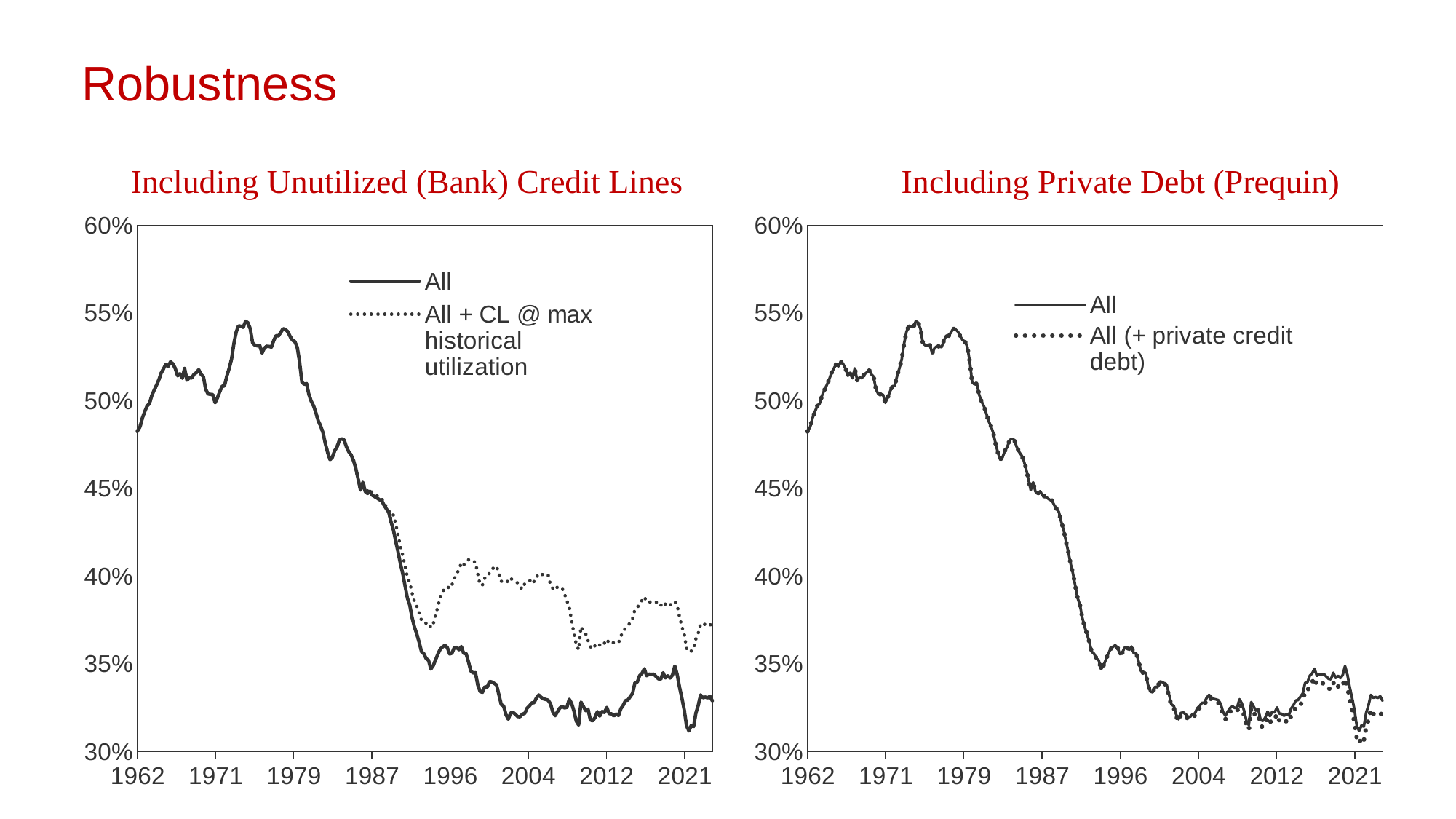
In the left chart titled "Including Unutilized (Bank) Credit Lines", which series has the higher value in 2004, "All" or "All + CL @ max historical utilization"? All + CL @ max historical utilization In the left chart titled "Including Unutilized (Bank) Credit Lines", is the value of the "All" series in 1962 greater or less than 50%? less In the right chart titled "Including Private Debt (Prequin)", does the "All" series overall rise or fall from 1979 to 2004? fall What kind of chart is the left chart titled "Including Unutilized (Bank) Credit Lines"? line chart In the left chart titled "Including Unutilized (Bank) Credit Lines", does the "All" series overall rise or fall from 1962 to 2021? fall How many series does the legend of the left chart titled "Including Unutilized (Bank) Credit Lines" list? 2 In the left chart titled "Including Unutilized (Bank) Credit Lines", is the value of the "All" series in 2004 greater or less than 35%? less In the right chart titled "Including Private Debt (Prequin)", is the value of the "All" series in 1979 greater or less than 50%? greater In the right chart titled "Including Private Debt (Prequin)", what is the name of the dotted series? All (+ private credit debt) How many year labels are shown on the x axis of the right chart titled "Including Private Debt (Prequin)"? 8 How many series does the legend of the right chart titled "Including Private Debt (Prequin)" list? 2 In the left chart titled "Including Unutilized (Bank) Credit Lines", what is the name of the dotted series? All + CL @ max historical utilization